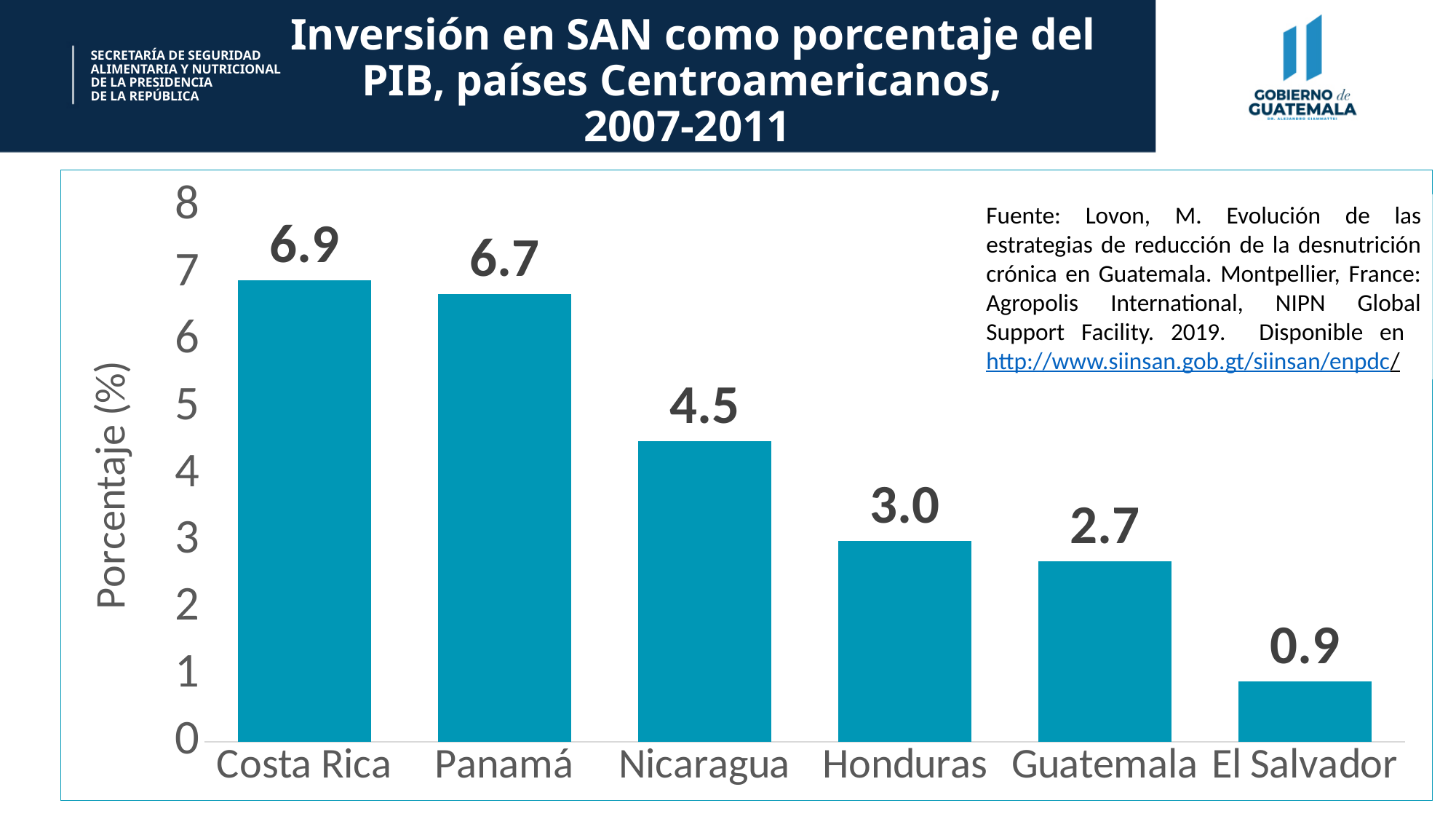
What is the label of the vertical axis? Porcentaje (%) Which is larger, the value for Nicaragua or the value for Honduras? Nicaragua What is the value for Nicaragua? 4.5 Which country has the highest value? Costa Rica What is the value for Costa Rica? 6.9 What is the difference between the values for Honduras and Guatemala? 0.3 Do the values rise or fall from left to right across the countries? Fall How many countries are shown in the chart? 6 What kind of chart is shown on the slide? Bar chart What is the difference between the values for Costa Rica and El Salvador? 6.0 What is the value for El Salvador? 0.9 Which country has the lowest value? El Salvador